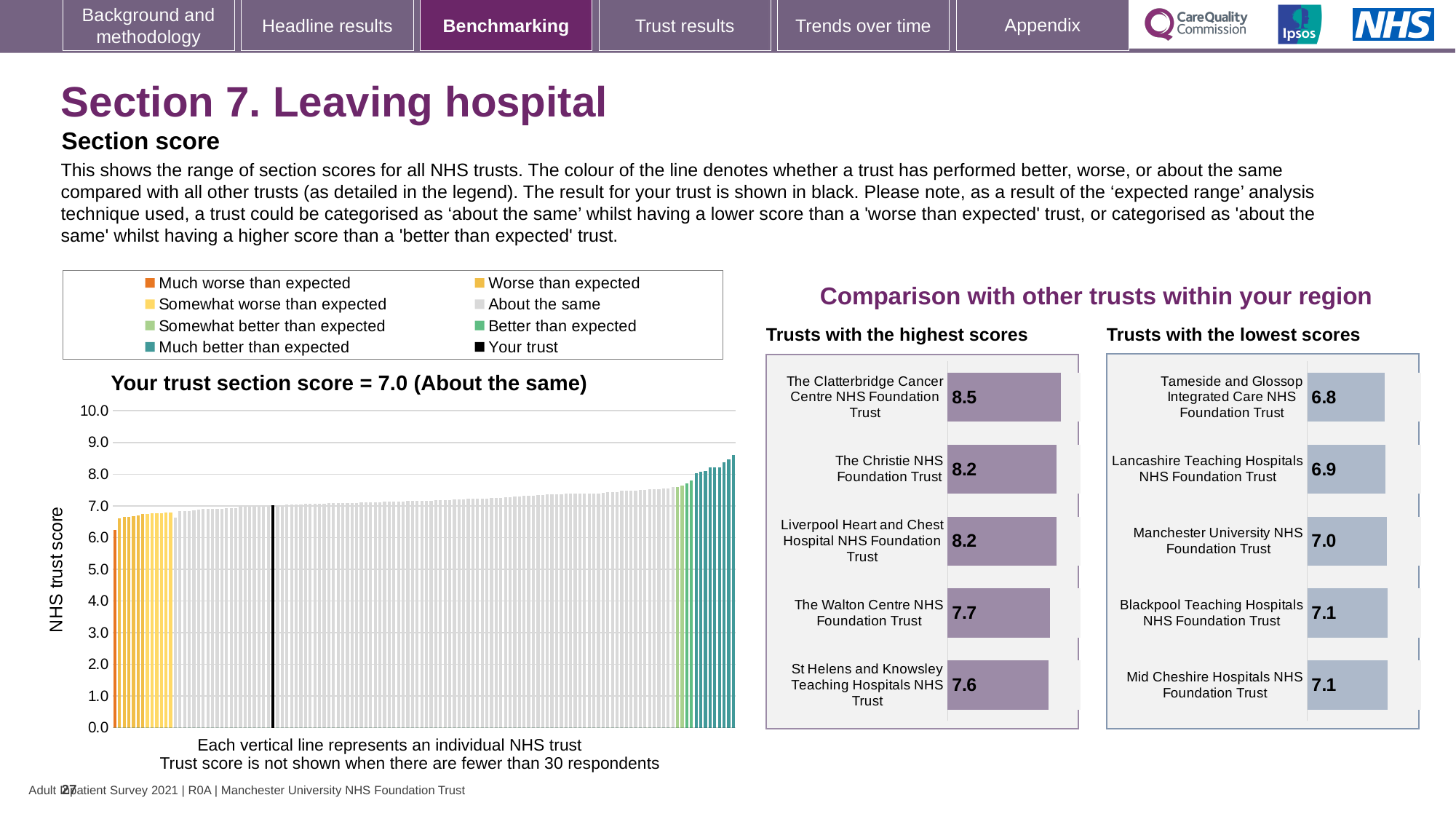
What kind of chart is the 'Your trust section score' chart on the left? Bar chart In the 'Trusts with the lowest scores' chart, what is the score for Tameside and Glossop Integrated Care NHS Foundation Trust? 6.8 How many entries does the legend above the 'Your trust section score' chart list? 8 In the 'Your trust section score' chart on the left, do the bar values rise or fall from left to right along the x axis? Rise In the 'Trusts with the highest scores' chart, which trust has the highest score? The Clatterbridge Cancer Centre NHS Foundation Trust In the 'Trusts with the lowest scores' chart, what is the difference between the scores of Lancashire Teaching Hospitals NHS Foundation Trust and Tameside and Glossop Integrated Care NHS Foundation Trust? 0.1 In the 'Trusts with the highest scores' chart, which has the larger score: The Christie NHS Foundation Trust or The Walton Centre NHS Foundation Trust? The Christie NHS Foundation Trust In the 'Trusts with the lowest scores' chart, which trust has the lowest score? Tameside and Glossop Integrated Care NHS Foundation Trust In the 'Trusts with the highest scores' chart, what is the score for The Clatterbridge Cancer Centre NHS Foundation Trust? 8.5 In the 'Trusts with the highest scores' chart, what is the difference between the scores of The Clatterbridge Cancer Centre NHS Foundation Trust and St Helens and Knowsley Teaching Hospitals NHS Trust? 0.9 How many trusts are shown in the 'Trusts with the highest scores' chart? 5 According to the title of the chart on the left, what is your trust's section score? 7.0